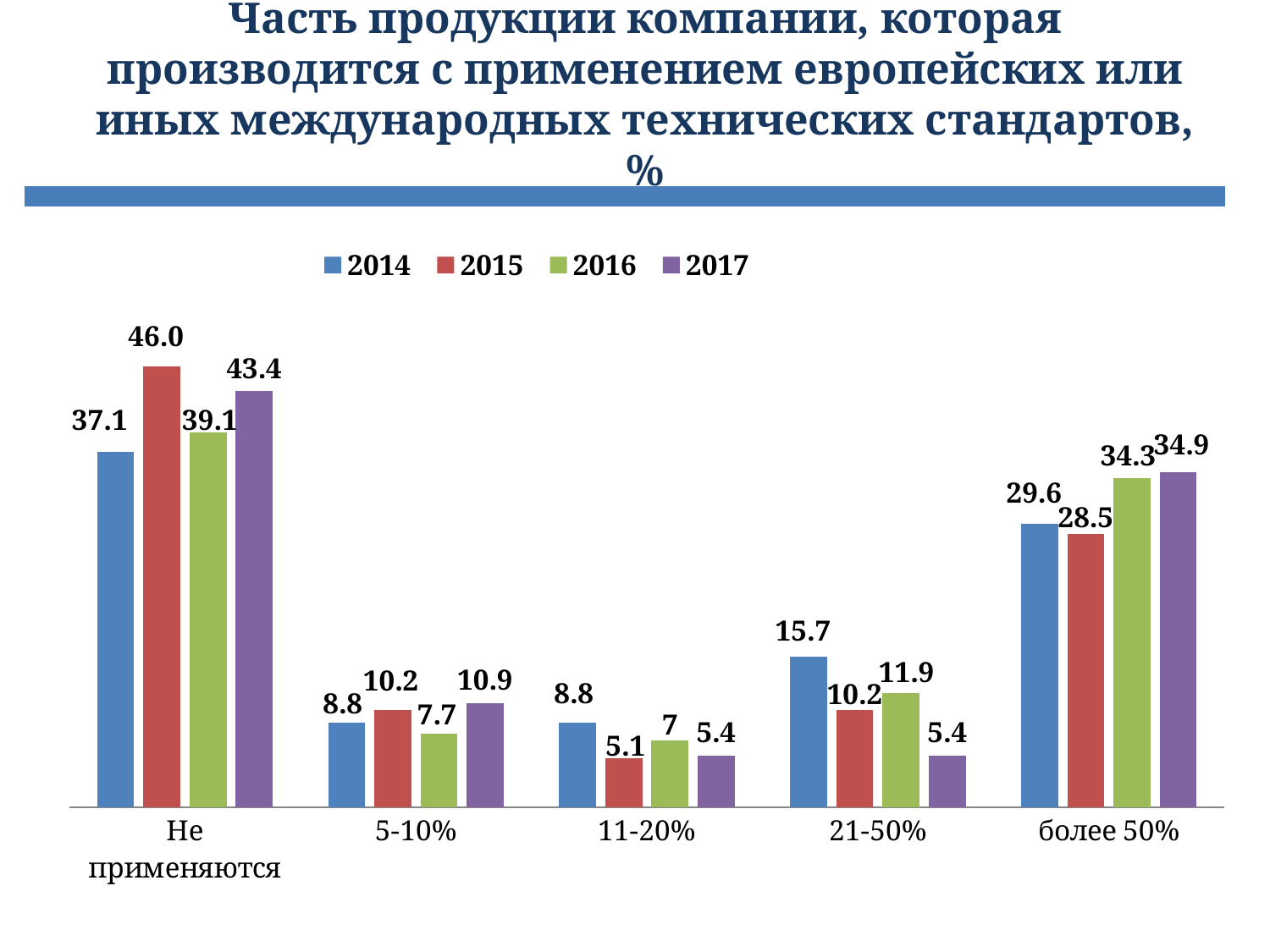
How many categories are shown on the x axis? 5 What kind of chart is shown on the slide? bar chart How many series does the legend list? 4 Which is larger in the '5-10%' category: the value for 2014 or the value for 2016? 2014 Which colour represents the 2016 series in the legend? green Does the value for 2017 rise or fall from the '5-10%' category to the '11-20%' category? fall What is the value for 2015 in the 'Не применяются' category? 46.0 What is the difference between the 2015 and 2014 values in the 'Не применяются' category? 8.9 Which year has the highest value in the 'Не применяются' category? 2015 What is the value for 2017 in the 'более 50%' category? 34.9 What is the value for 2016 in the '21-50%' category? 11.9 Which year has the lowest value in the '11-20%' category? 2015